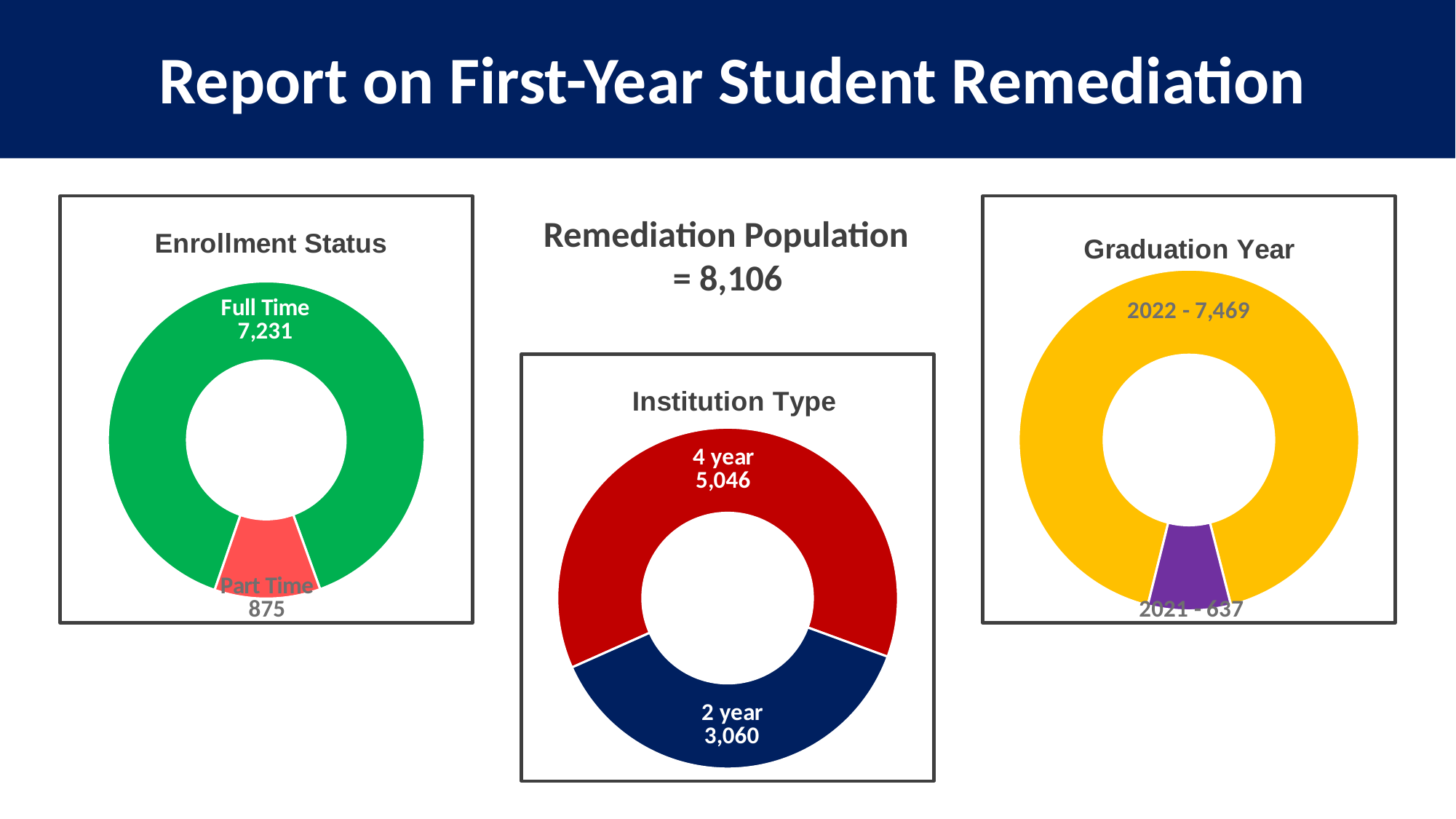
In the Institution Type chart, what is the value for 4 year institutions? 5,046 How many categories does the Institution Type chart show? 2 In the Institution Type chart, which is larger, 4 year or 2 year? 4 year In the Graduation Year chart, what is the value for 2021? 637 In the Graduation Year chart, what is the value for 2022? 7,469 In the Graduation Year chart, which category is the largest? 2022 In the Enrollment Status chart, what is the value for Part Time? 875 In the Institution Type chart, what is the value for 2 year institutions? 3,060 What kind of chart is the Enrollment Status chart? Doughnut chart In the Enrollment Status chart, what is the value for Full Time? 7,231 In the Institution Type chart, what is the difference between 4 year and 2 year? 1,986 In the Enrollment Status chart, what is the difference between Full Time and Part Time? 6,356